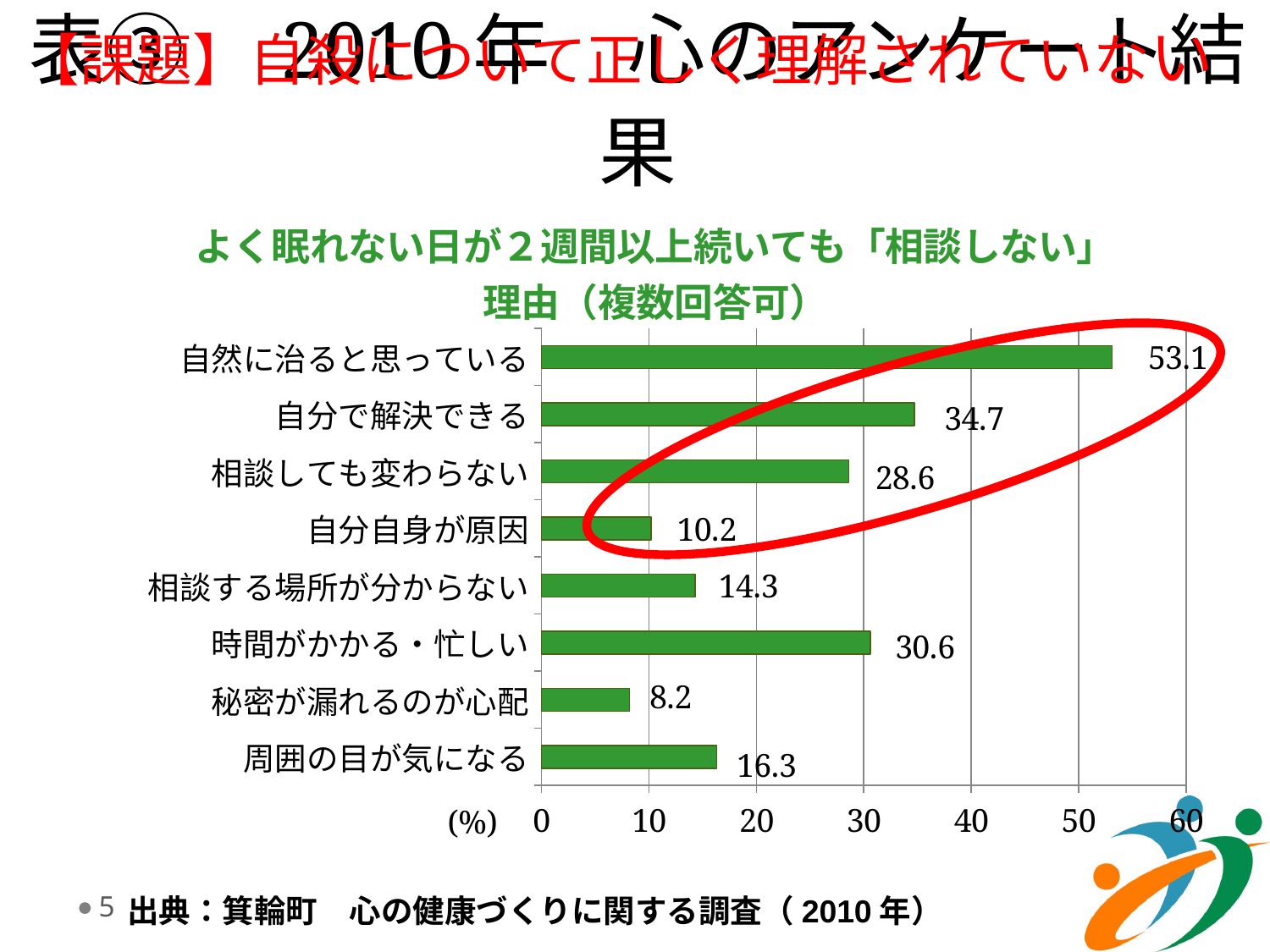
Which category has the lowest value? 秘密が漏れるのが心配 What is the difference between the values for 自然に治ると思っている and 自分で解決できる? 18.4 Which is larger, the value for 相談しても変わらない or the value for 時間がかかる・忙しい? 時間がかかる・忙しい Is the value for 周囲の目が気になる greater or less than 20? less What unit is indicated on the horizontal axis of the chart? (%) What is the value for 時間がかかる・忙しい? 30.6 What kind of chart is shown on the slide? bar chart What is the value for 秘密が漏れるのが心配? 8.2 How many categories are shown in the chart? 8 Which category has the highest value? 自然に治ると思っている What is the value for 自然に治ると思っている? 53.1 What is the difference between the values for 相談する場所が分からない and 自分自身が原因? 4.1